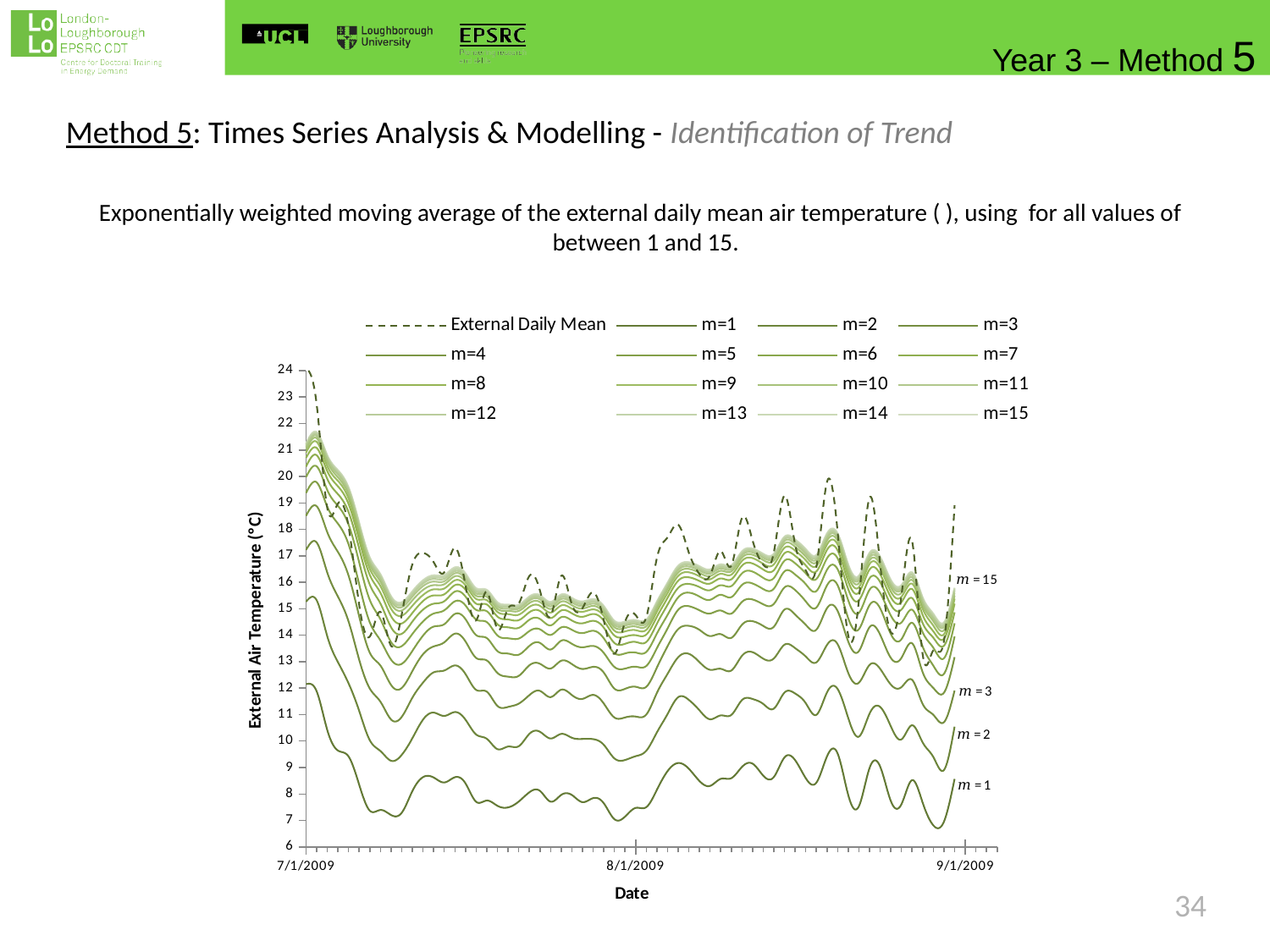
How many series does the legend list? 16 What is the title of the horizontal axis? Date Which series is drawn with a dashed line? External Daily Mean Does the m=1 series rise or fall between 7/1/2009 and the middle of July 2009? fall What kind of chart is shown on the slide? line chart Is the value of the External Daily Mean at 7/1/2009 greater or less than 22? greater Is the value of m=2 at 9/1/2009 greater or less than 12? less How many date labels are shown on the horizontal axis? 3 What is the title of the vertical axis? External Air Temperature (°C) Which series lies lowest on the chart across the whole period? m=1 At 7/1/2009, which is higher: m=1 or m=15? m=15